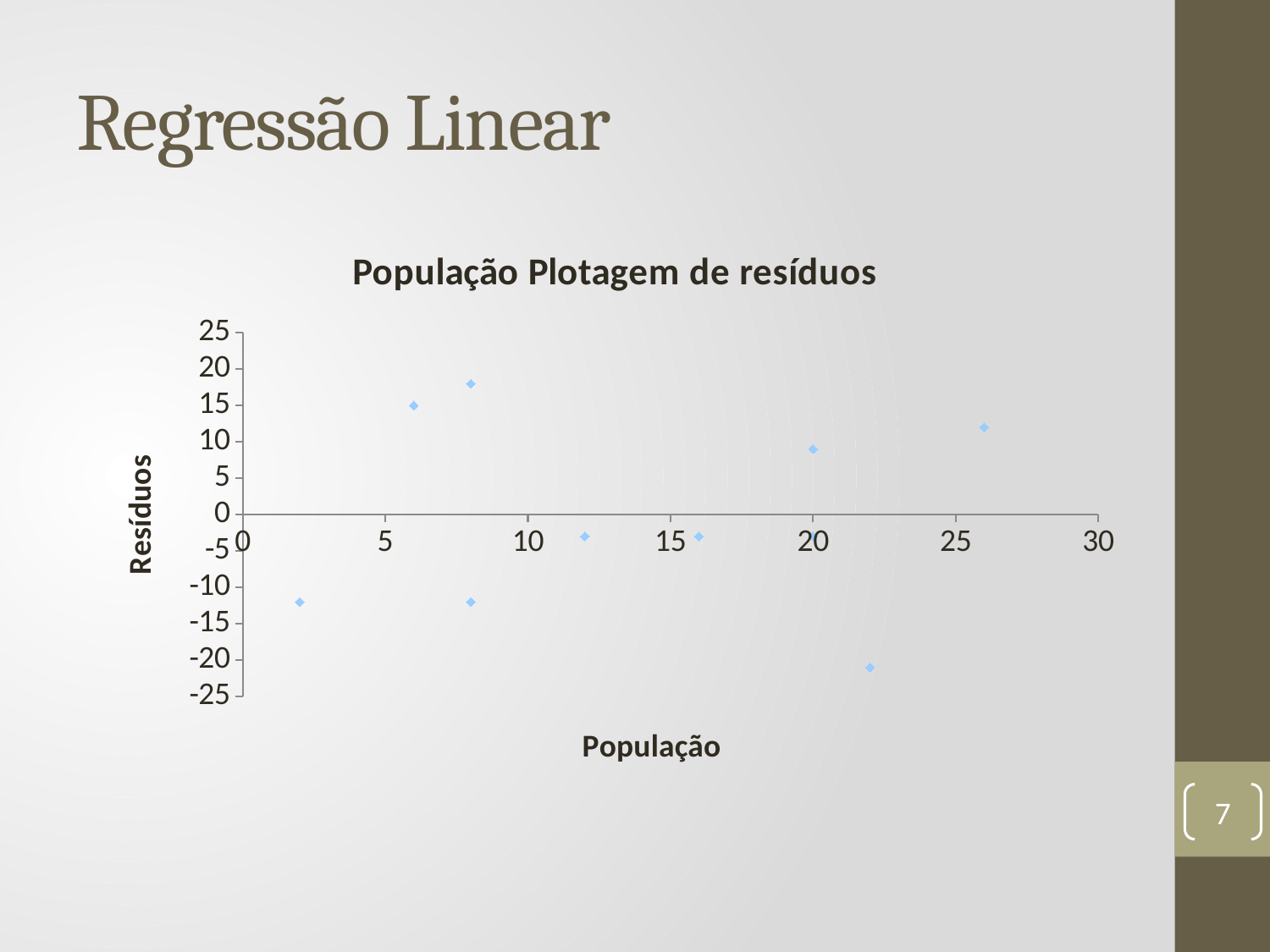
How many data points are plotted in the chart? 10 Is the residual of the leftmost point in the chart greater or less than -5? less What kind of chart is shown on the slide? Scatter chart Is the residual of the highest point in the chart greater or less than 15? greater Is the residual of the lowest point in the chart (near population 22) greater or less than -15? less Which point has the highest residual value: the one near population 8 above the axis, or the one near population 26? The one near population 8 Which point has a lower residual: the one near population 22 or the one near population 2? The one near population 22 What is the title of the chart? População Plotagem de resíduos What is the label of the vertical axis of the chart? Resíduos